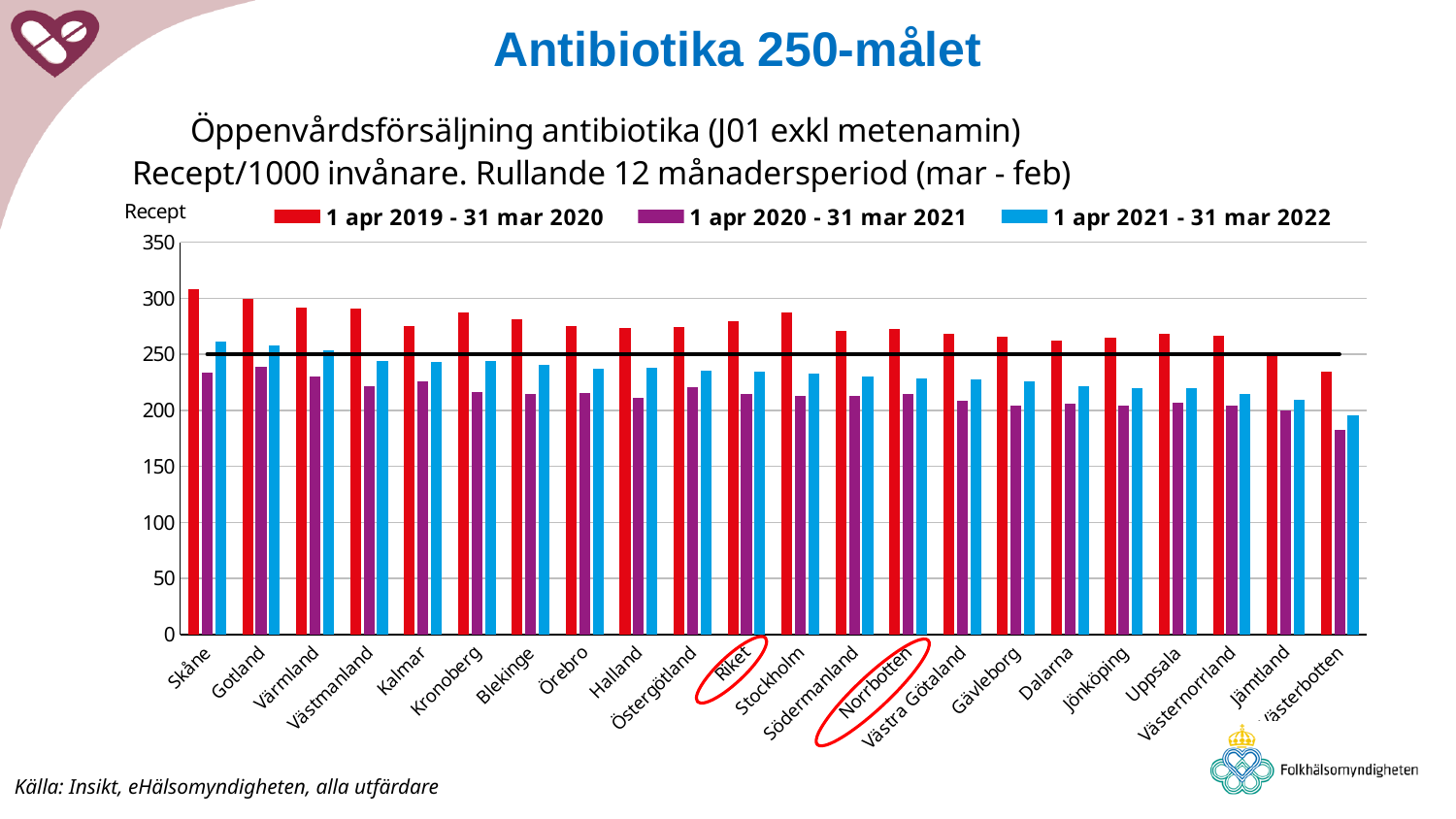
Is the value for Skåne in the series 1 apr 2019 - 31 mar 2020 greater or less than 250? greater Is the value for Västerbotten in the series 1 apr 2020 - 31 mar 2021 greater or less than 200? less What kind of chart is shown on the slide? bar chart Do the values for the series 1 apr 2019 - 31 mar 2020 generally rise or fall from left to right along the x axis? fall For Skåne, which is larger: the value for 1 apr 2019 - 31 mar 2020 or the value for 1 apr 2021 - 31 mar 2022? 1 apr 2019 - 31 mar 2020 How many series does the legend list? 3 How many regions (categories) are shown on the x axis? 22 Is the value for Västerbotten in the series 1 apr 2019 - 31 mar 2020 greater or less than 250? less At what value is the horizontal black target line drawn across the chart? 250 Which region has the highest value for the series 1 apr 2019 - 31 mar 2020? Skåne Which region has the lowest value for the series 1 apr 2021 - 31 mar 2022? Västerbotten Which region has the lowest value for the series 1 apr 2019 - 31 mar 2020? Västerbotten